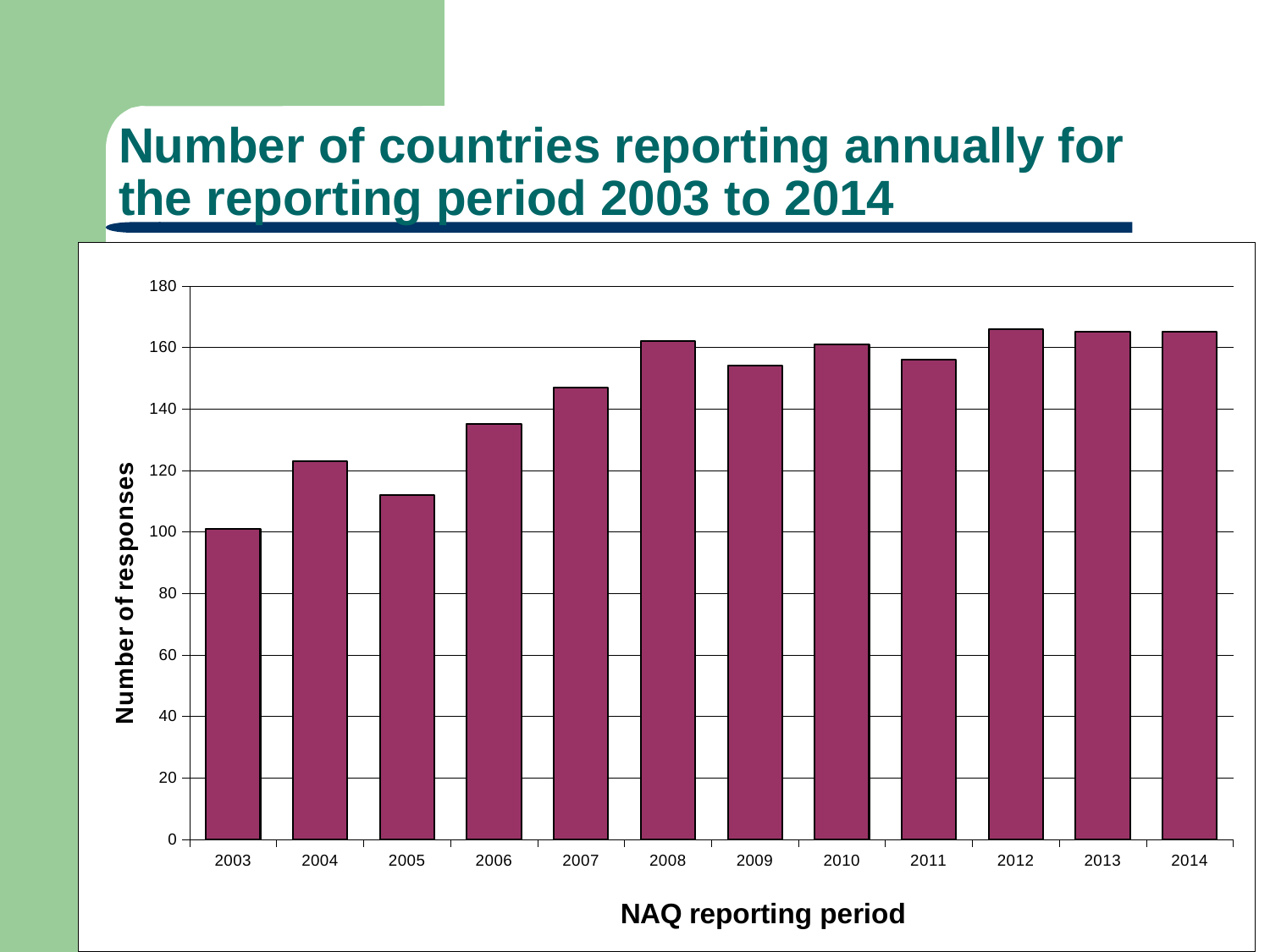
Is the value for 2006 greater or less than 120? greater Is the value for 2003 greater or less than 120? less Is the value for 2012 greater or less than 160? greater What is the label on the vertical axis of the chart? Number of responses Which has a higher number of responses, 2008 or 2009? 2008 Which has a higher number of responses, 2004 or 2005? 2004 What kind of chart is shown on the slide? bar chart Which reporting period has the lowest number of responses? 2003 Overall, do the values rise or fall from 2003 to 2014? rise How many reporting periods (bars) are shown on the chart? 12